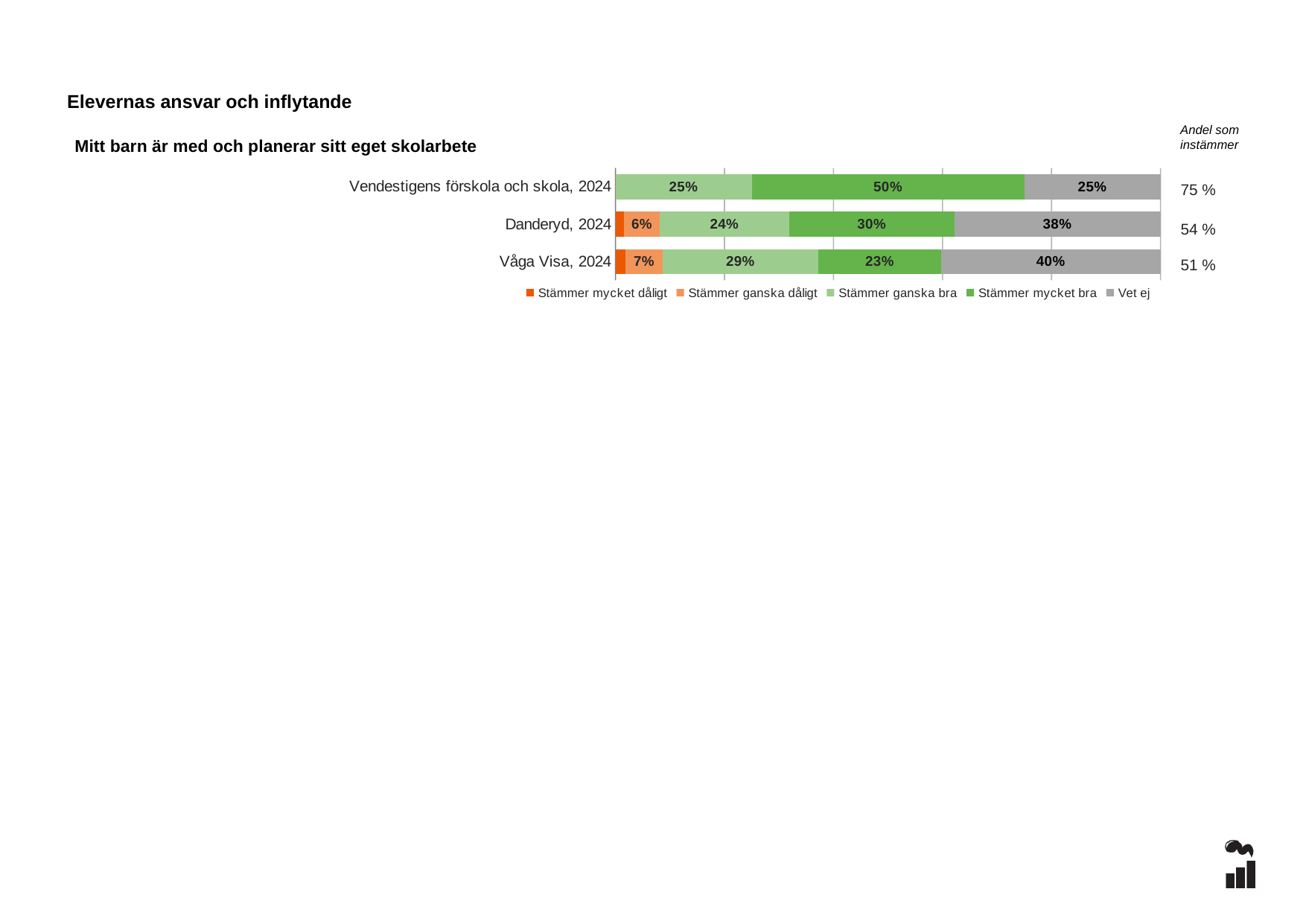
What kind of chart is shown on the slide? Stacked bar chart How many categories (rows) are plotted in the chart? 3 How many series does the legend list? 5 What is the value of 'Stämmer ganska bra' for Våga Visa, 2024? 29% Which category has the highest 'Stämmer mycket bra' value? Vendestigens förskola och skola, 2024 What is the statement shown as the chart's title? Mitt barn är med och planerar sitt eget skolarbete What is the difference between the 'Stämmer mycket bra' values for Vendestigens förskola och skola, 2024 and Danderyd, 2024? 20 percentage points What is the 'Andel som instämmer' value shown for Vendestigens förskola och skola, 2024? 75 % What is the value of 'Stämmer mycket bra' for Vendestigens förskola och skola, 2024? 50% Which is larger: the 'Vet ej' value for Våga Visa, 2024 or for Danderyd, 2024? Våga Visa, 2024 What is the value of 'Vet ej' for Danderyd, 2024? 38% Which category has the lowest 'Andel som instämmer' value? Våga Visa, 2024